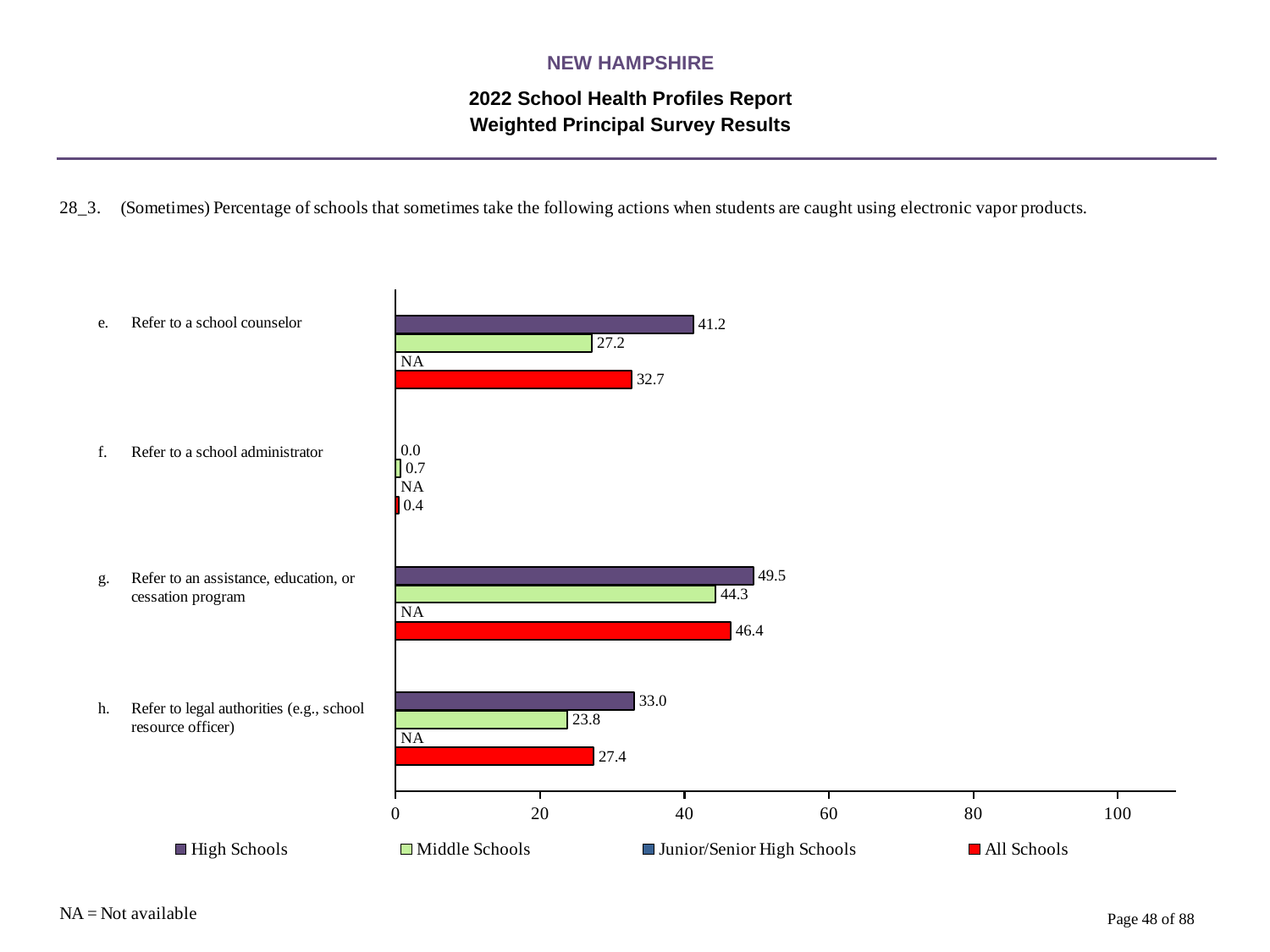
Is the All Schools value for 'Refer to an assistance, education, or cessation program' greater or less than 40? greater Which action has the lowest All Schools value? Refer to a school administrator What kind of chart is shown on the slide? Bar chart What is the High Schools value for 'Refer to a school counselor'? 41.2 How many actions (categories) are shown on the chart? 4 What is the All Schools value for 'Refer to an assistance, education, or cessation program'? 46.4 What value is shown for Junior/Senior High Schools for 'Refer to a school administrator'? NA Which action has the highest High Schools value? Refer to an assistance, education, or cessation program How many series does the legend list? 4 What is the Middle Schools value for 'Refer to legal authorities (e.g., school resource officer)'? 23.8 For 'Refer to legal authorities (e.g., school resource officer)', which is larger: the High Schools value or the All Schools value? High Schools What is the difference between the High Schools and Middle Schools values for 'Refer to a school counselor'? 14.0